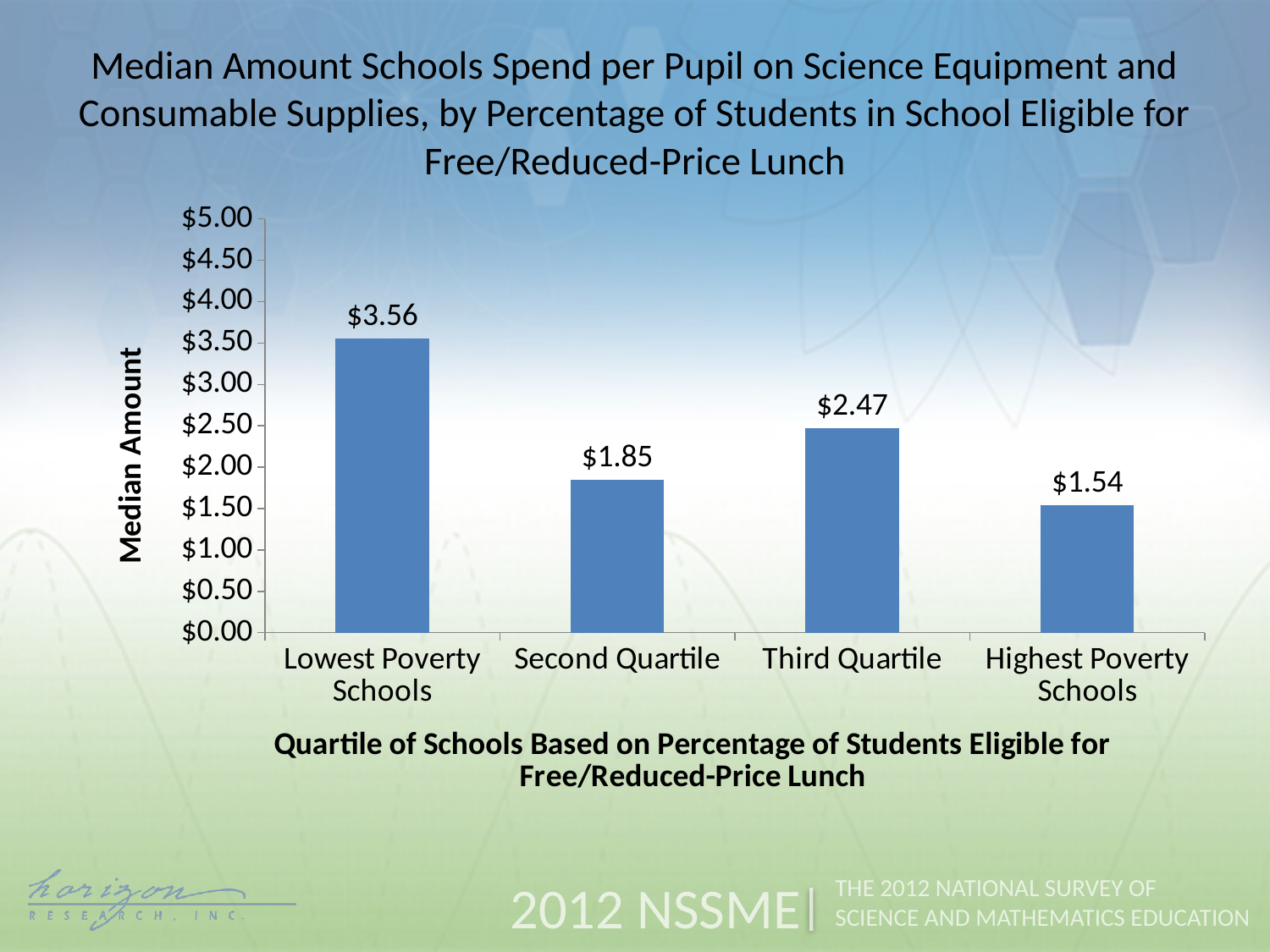
What is the median amount spent per pupil for the Second Quartile? $1.85 Which quartile has the lowest median amount spent per pupil? Highest Poverty Schools Which has a larger median amount, the Second Quartile or the Third Quartile? Third Quartile What is the median amount spent per pupil for the Third Quartile? $2.47 What is the difference between the median amounts for Lowest Poverty Schools and Highest Poverty Schools? $2.02 What is the difference between the median amounts for the Third Quartile and the Second Quartile? $0.62 What is the median amount spent per pupil for Lowest Poverty Schools? $3.56 What is the median amount spent per pupil for Highest Poverty Schools? $1.54 How many quartile categories are shown on the x axis? 4 What kind of chart is shown on the slide? Bar chart Which quartile has the highest median amount spent per pupil? Lowest Poverty Schools Is the value for Lowest Poverty Schools greater or less than $3.00? greater